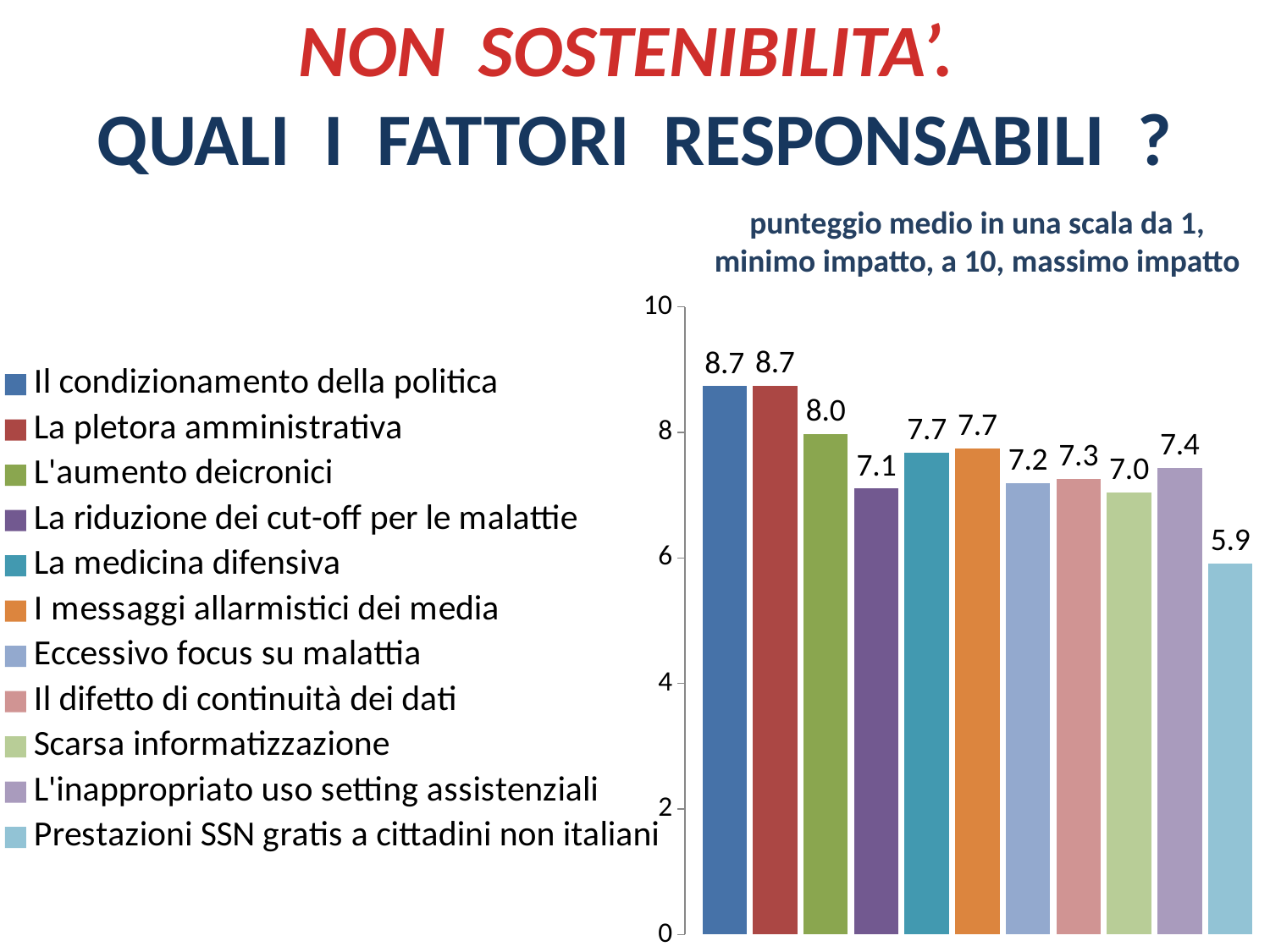
What is the value for La medicina difensiva? 7.7 What is the value for Prestazioni SSN gratis a cittadini non italiani? 5.9 What is the value for L'aumento deicronici? 8.0 Is the value for Il difetto di continuità dei dati greater or less than 8? less What kind of chart is shown on the slide? bar chart Which factor has the lowest score? Prestazioni SSN gratis a cittadini non italiani What is the difference between the value for Il condizionamento della politica and the value for Prestazioni SSN gratis a cittadini non italiani? 2.8 What is the difference between the value for L'aumento deicronici and the value for La riduzione dei cut-off per le malattie? 0.9 What is the value for Scarsa informatizzazione? 7.0 Which is larger, the value for L'inappropriato uso setting assistenziali or the value for Eccessivo focus su malattia? L'inappropriato uso setting assistenziali How many entries does the legend list? 11 How many bars are plotted in the chart? 11